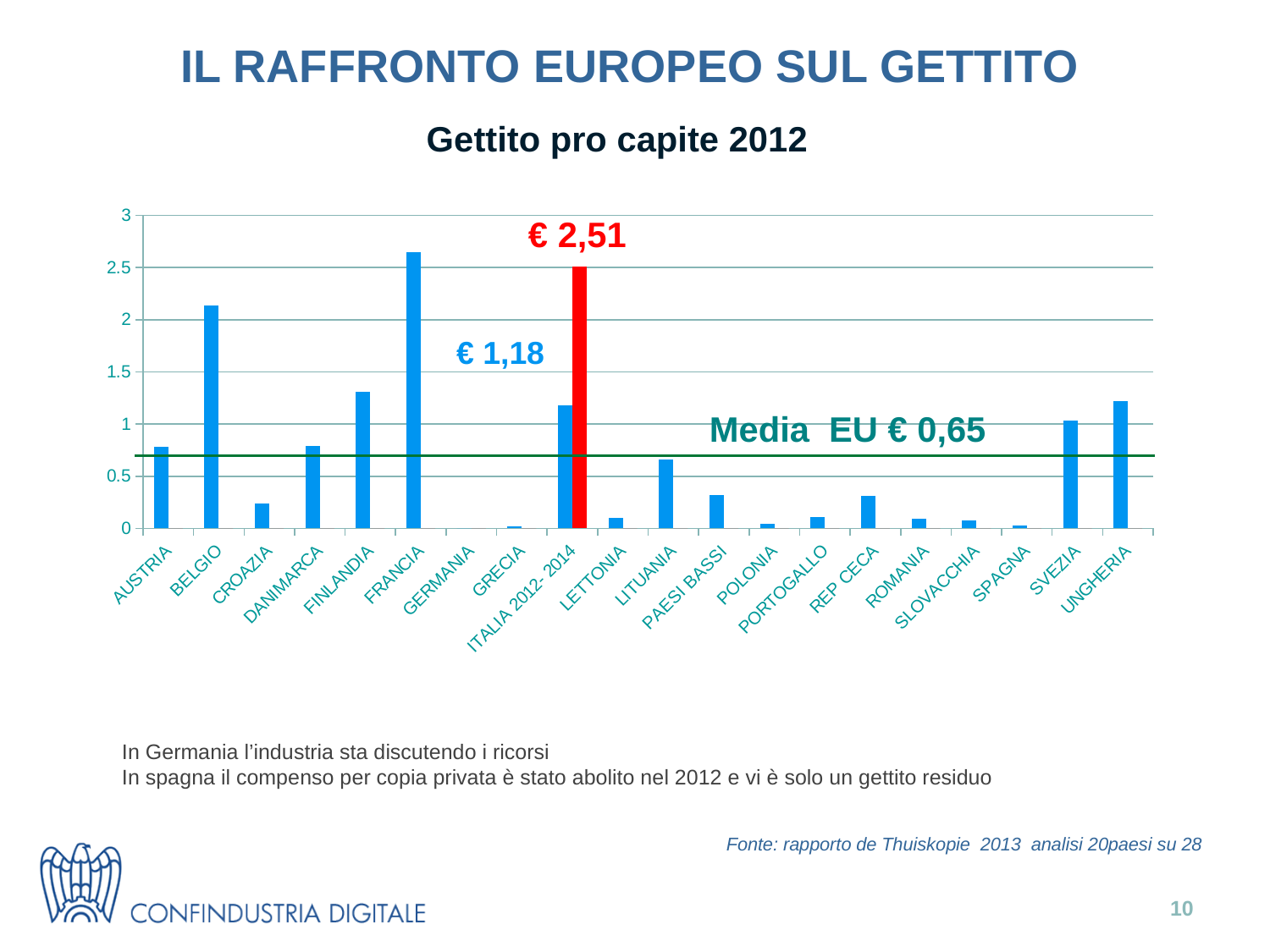
What is the difference between the two values labelled for Italia 2012-2014 (€ 2,51 and € 1,18)? € 1,33 What is the title of the chart? Gettito pro capite 2012 Is the value for Belgio greater or less than 2? greater What kind of chart is shown on the slide? Bar chart Is the value for Croazia greater or less than 0.5? less Is the value for Finlandia greater or less than 1? greater Which country has the highest blue bar in the chart? Francia Which has a larger value, Belgio or Finlandia? Belgio How many countries are listed on the x axis of the chart? 20 What is the value shown for the red bar for Italia 2012-2014? € 2,51 What is the EU average (Media EU) shown on the chart? € 0,65 What is the value shown for the blue bar for Italia 2012-2014? € 1,18